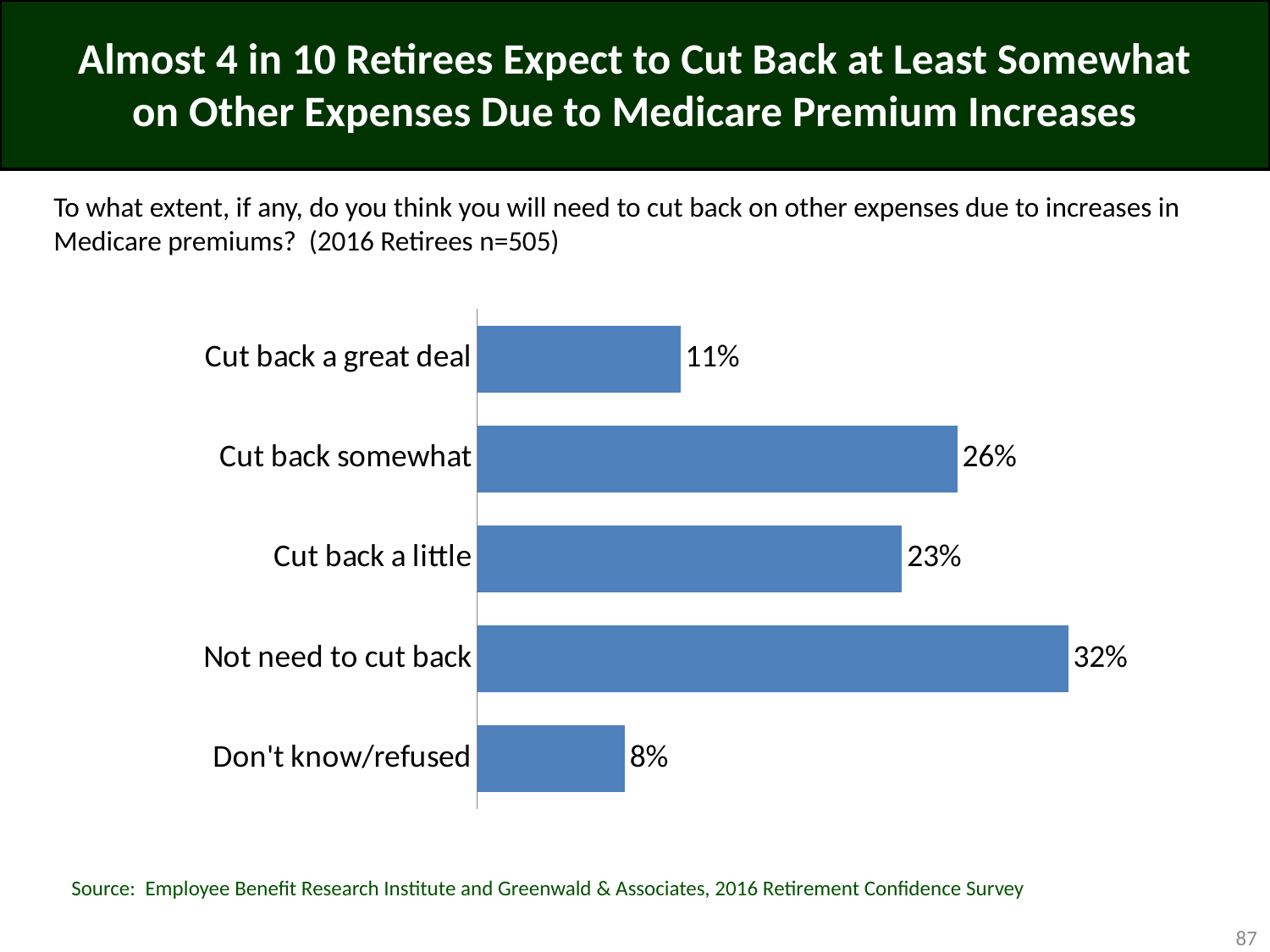
Which response category has the lowest percentage? Don't know/refused What percentage of retirees answered don't know/refused? 8% What percentage of retirees said they would need to cut back somewhat? 26% What type of chart is shown on the slide? Bar chart What percentage of retirees said they would not need to cut back? 32% Which is larger, the percentage for 'Cut back a great deal' or for 'Cut back a little'? Cut back a little What percentage of retirees said they would need to cut back a great deal? 11% What is the combined percentage of retirees who said they would cut back a great deal or cut back somewhat? 37% Which response category has the highest percentage? Not need to cut back What is the difference in percentage points between 'Cut back somewhat' and 'Cut back a little'? 3 percentage points What is the sample size of 2016 retirees given in the question text above the chart? n=505 How many response categories are shown in the chart? 5